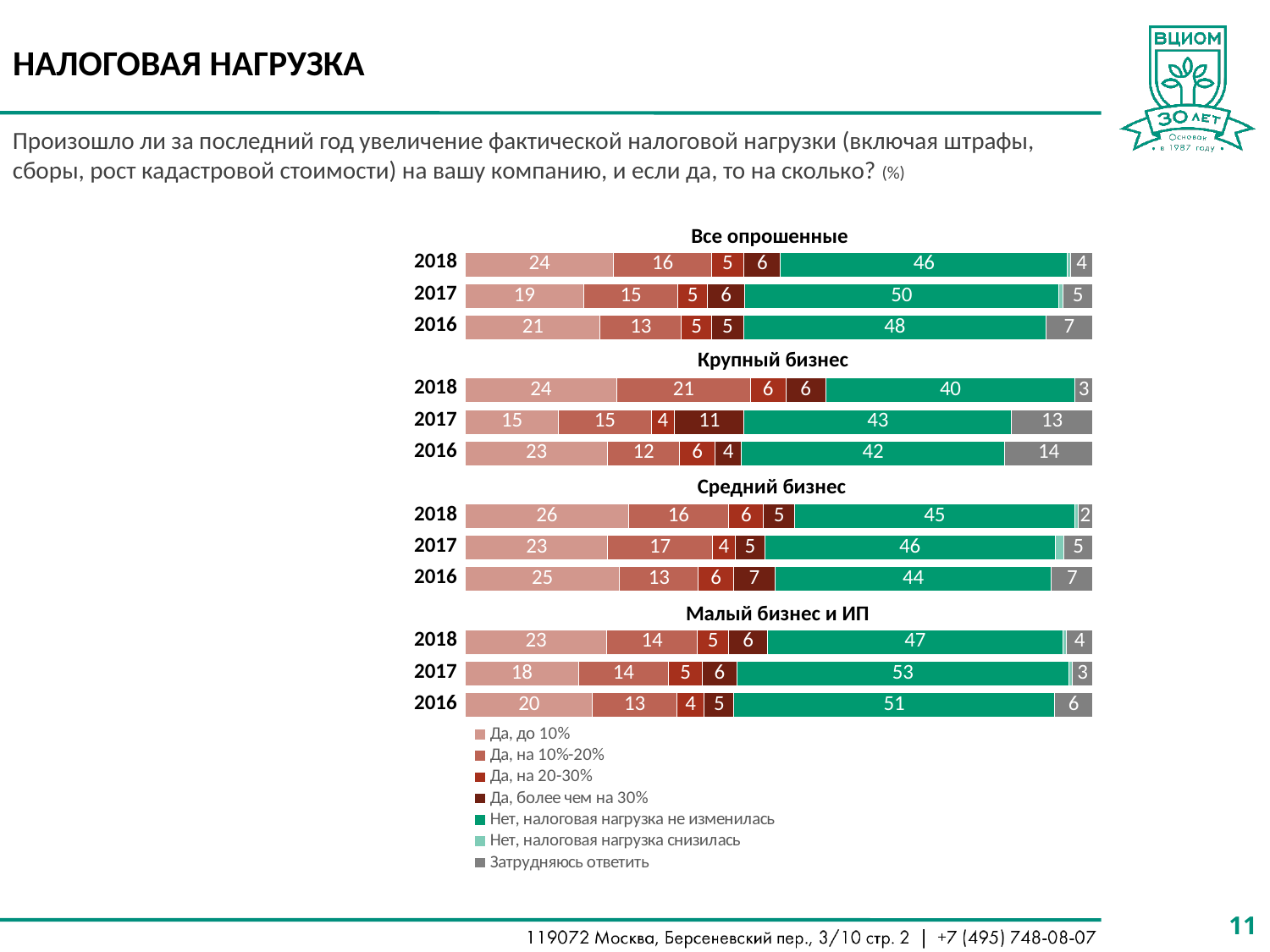
In the 'Крупный бизнес' chart, what is the value for 'Затрудняюсь ответить' in 2017? 13 In the 'Средний бизнес' chart, which year has the lowest value for 'Затрудняюсь ответить'? 2018 In the 'Средний бизнес' chart, what is the value for 'Да, до 10%' in 2018? 26 In the 'Крупный бизнес' chart, what is the total of the 2018 bar? 100 In the 'Все опрошенные' chart, what is the difference between the 'Да, до 10%' values for 2018 and 2017? 5 In the 'Крупный бизнес' chart, which year has the highest value for 'Да, более чем на 30%'? 2017 In the 'Все опрошенные' chart, what is the value for 'Нет, налоговая нагрузка не изменилась' in 2017? 50 For 2016, which chart shows a larger value for 'Нет, налоговая нагрузка не изменилась': 'Средний бизнес' or 'Малый бизнес и ИП'? Малый бизнес и ИП What kind of chart is used on this slide? Stacked bar chart How many years are shown in the 'Крупный бизнес' chart? 3 In the 'Малый бизнес и ИП' chart, what is the value for 'Нет, налоговая нагрузка не изменилась' in 2017? 53 How many series does the legend list? 7